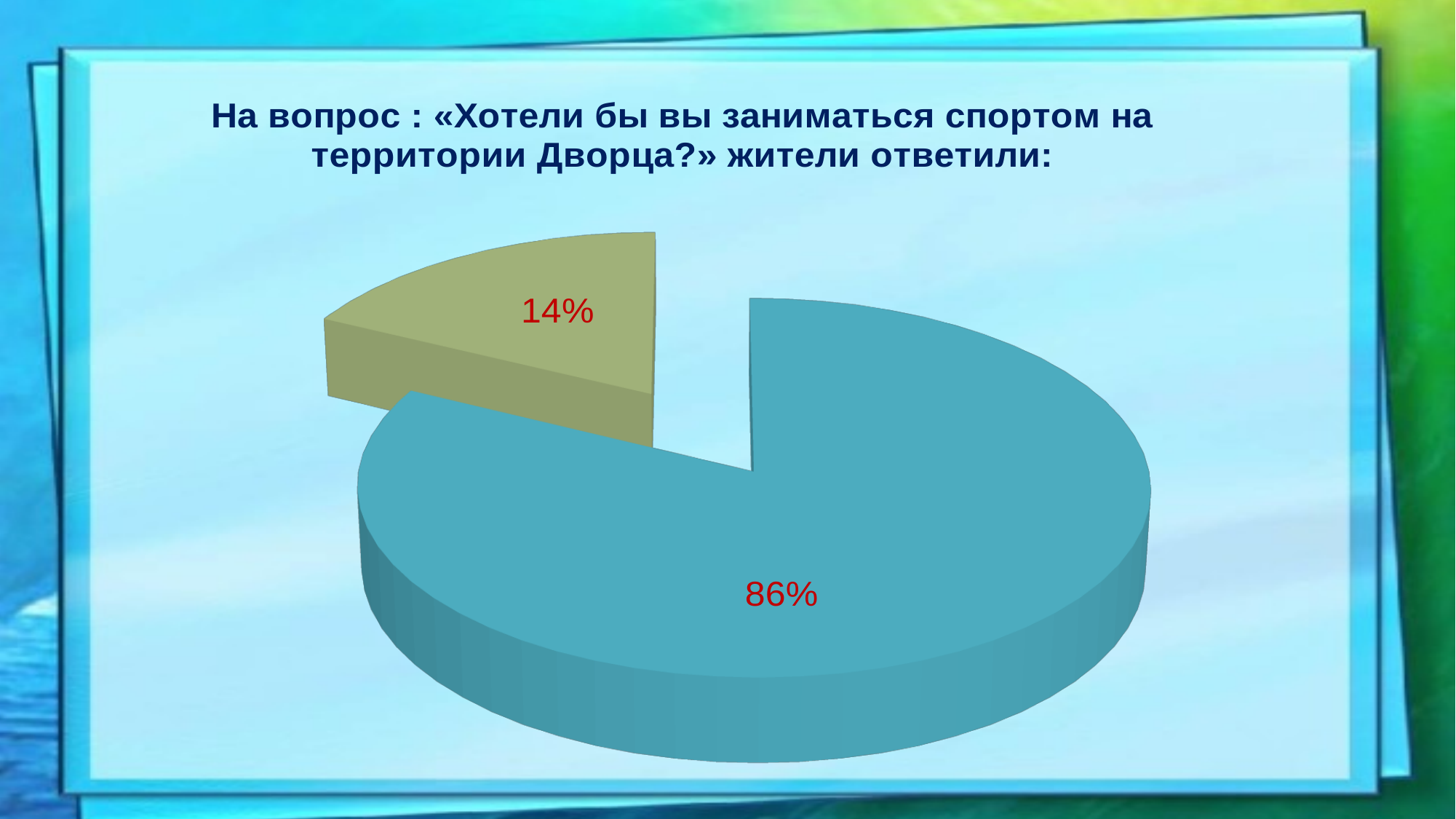
What percentage is shown on the blue slice of the pie chart? 86% What colour is the slice labelled 86%? blue What kind of chart is shown on the slide? pie chart How many slices does the pie chart have? 2 What is the value shown on the smallest slice of the pie chart? 14% What is the difference between the two slice values in the pie chart? 72% What percentage is shown on the olive-coloured slice of the pie chart? 14% What is the value shown on the largest slice of the pie chart? 86% What is the total of the two slice values shown on the pie chart? 100% Which slice is larger, the blue one or the olive-coloured one? the blue one Which slice is pulled out (exploded) from the pie chart? the 14% slice